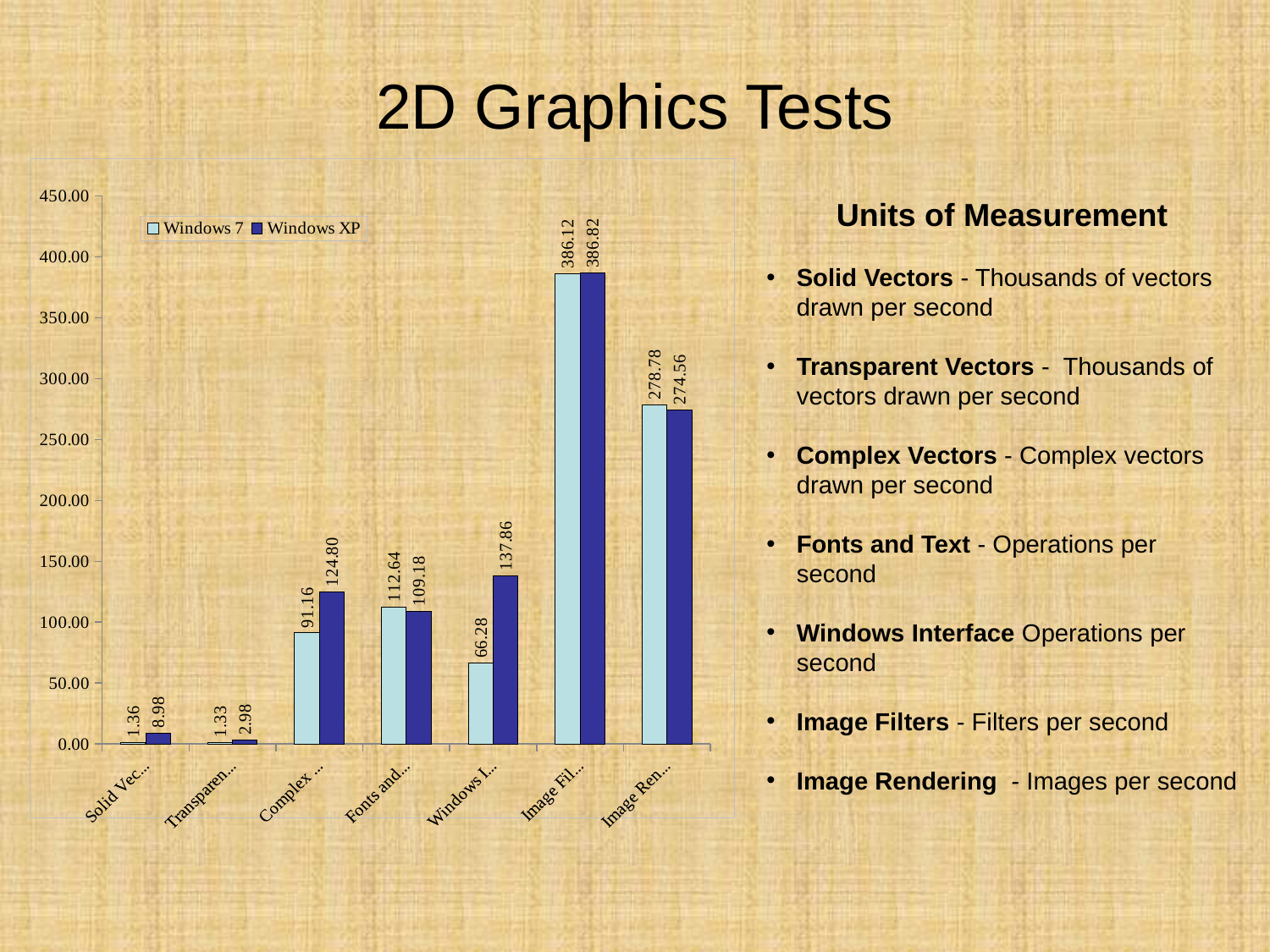
What kind of chart is shown on the slide? Bar chart For Windows Interface, which is larger: the Windows 7 value or the Windows XP value? Windows XP What is the Windows 7 value for Image Filters? 386.12 What is the difference between the Windows XP and Windows 7 values for Complex Vectors? 33.64 How many series does the legend list? 2 Which category has the highest Windows XP value? Image Filters What is the Windows XP value for Windows Interface? 137.86 What is the Windows 7 value for Fonts and Text? 112.64 What is the difference between the Windows XP and Windows 7 values for Windows Interface? 71.58 How many categories are shown on the x axis? 7 What is the Windows XP value for Complex Vectors? 124.80 Which category has the lowest Windows 7 value? Transparent Vectors